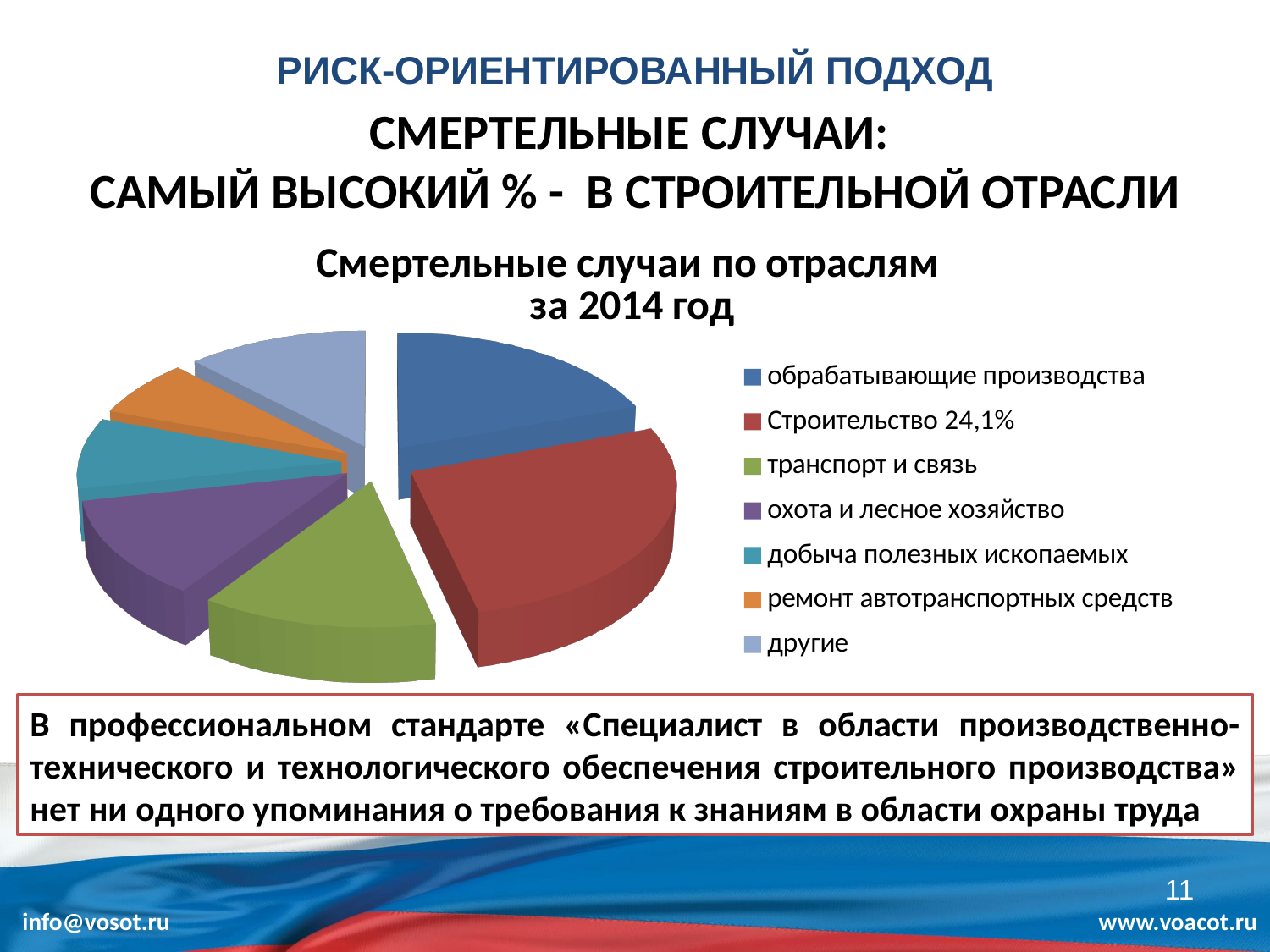
Which is larger: the slice for Строительство or the slice for транспорт и связь? Строительство What is the title of the chart? Смертельные случаи по отраслям за 2014 год What share of fatal cases does the legend give for Строительство? 24,1% Which legend entry is the only one with a percentage printed next to it? Строительство 24,1% How many categories (slices) does the pie chart have? 7 What colour is the slice for Строительство in the pie chart? red Which year does the chart cover? 2014 Which is larger: the slice for обрабатывающие производства or the slice for ремонт автотранспортных средств? обрабатывающие производства What kind of chart is shown on the slide? pie chart Which industry has the largest slice of the pie chart? Строительство Which is larger: the slice for охота и лесное хозяйство or the slice for ремонт автотранспортных средств? охота и лесное хозяйство